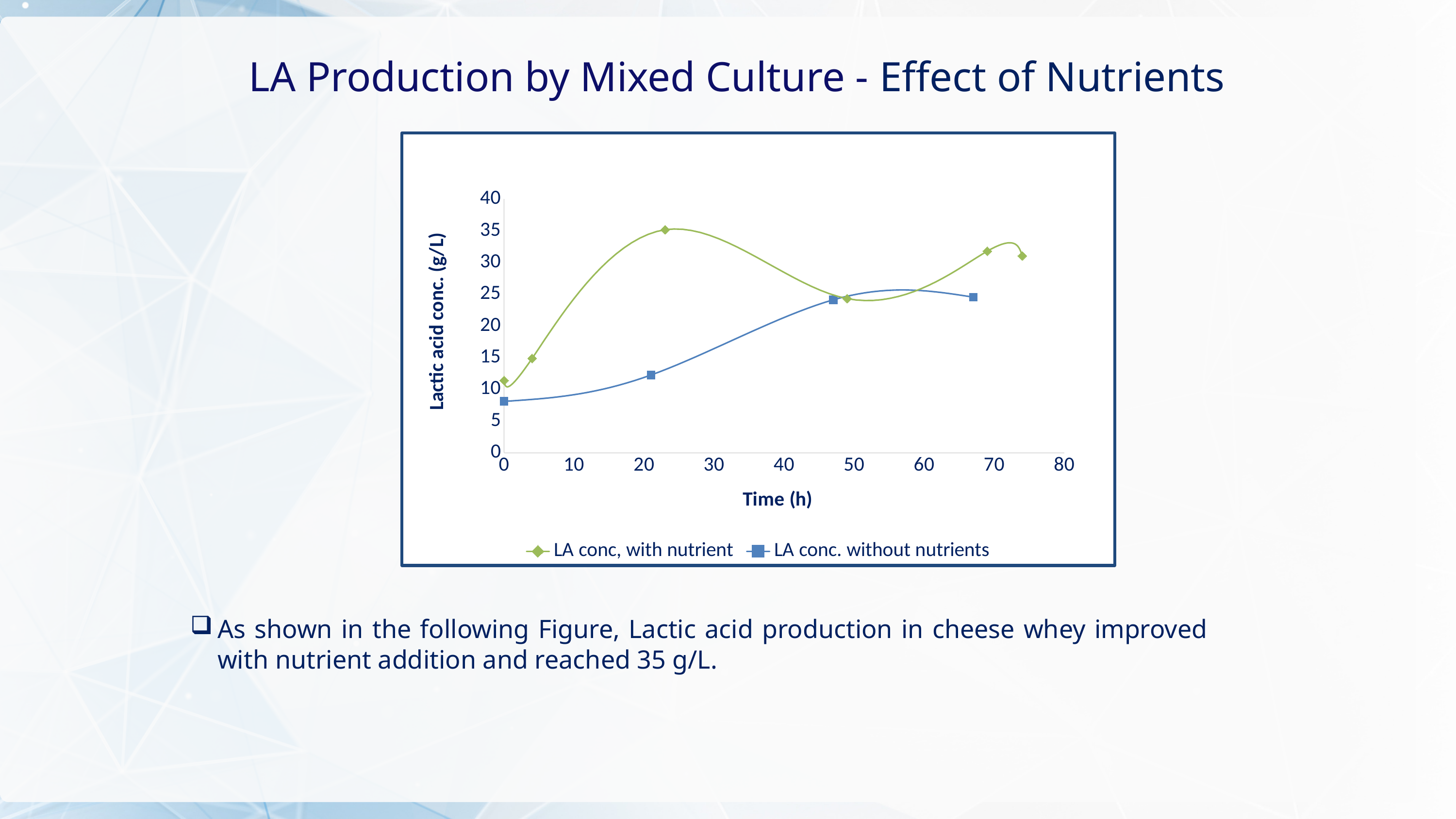
How many data points are plotted for the 'LA conc, with nutrient' series? 6 Is the value of the 'LA conc. without nutrients' series at time 0 greater or less than 10? less What is the label of the y axis? Lactic acid conc. (g/L) Around 70 h, which series has the higher lactic acid concentration? LA conc, with nutrient Is the last plotted value of the 'LA conc. without nutrients' series greater or less than 30? less What is the highest lactic acid concentration reached by the 'LA conc, with nutrient' series? 35 At time 0, which series has the higher lactic acid concentration? LA conc, with nutrient What kind of chart is shown on the slide? line chart Do the values of the 'LA conc. without nutrients' series rise or fall as time increases? rise How many data points are plotted for the 'LA conc. without nutrients' series? 4 How many series does the chart legend list? 2 Is the peak value of the 'LA conc, with nutrient' series greater or less than 30? greater